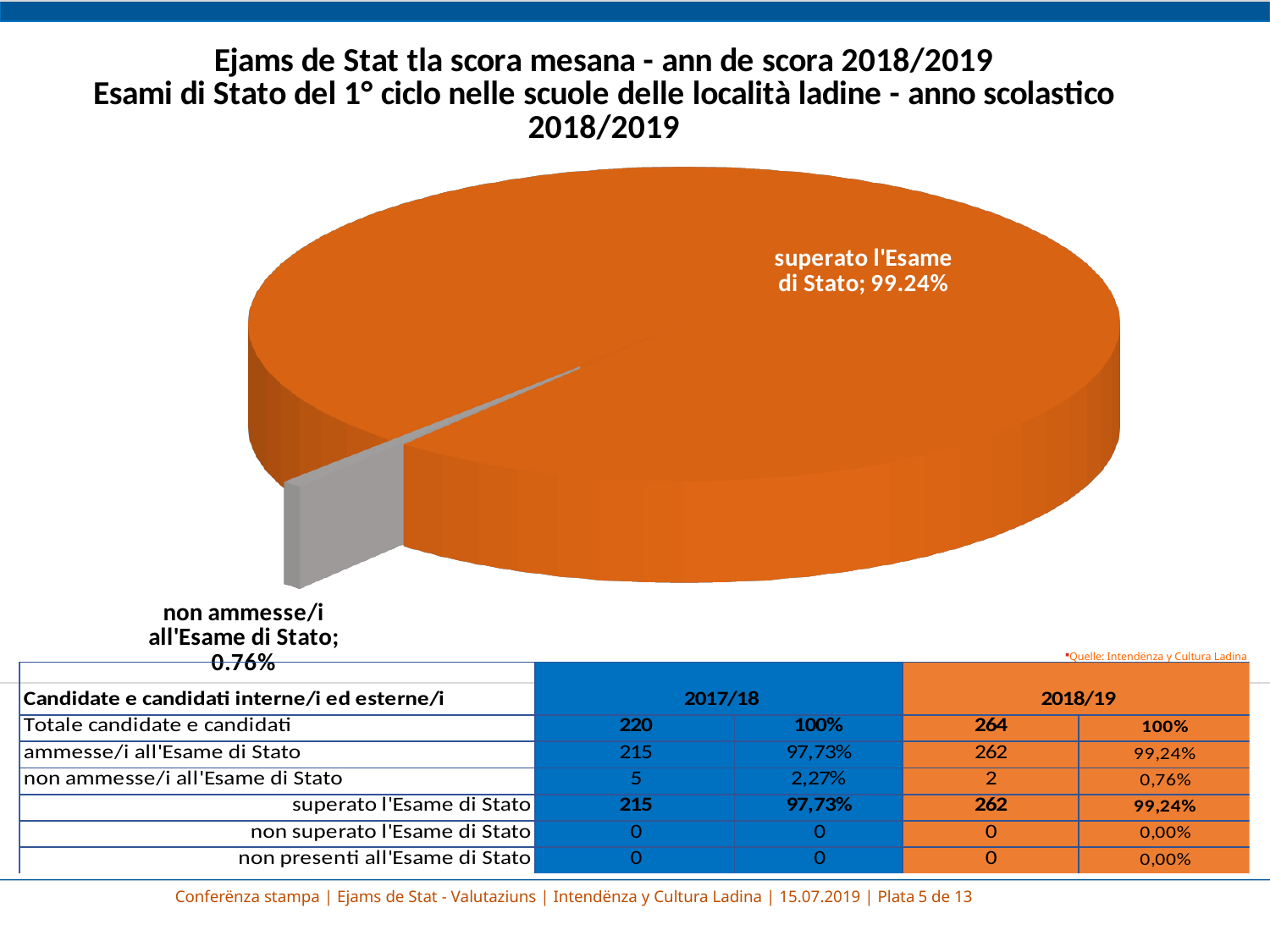
Which slice of the pie chart is the smallest? non ammesse/i all'Esame di Stato What kind of chart is shown on the slide? pie chart What is the value labelled for 'superato l'Esame di Stato' in the pie chart? 99.24% What share of the pie does the slice 'superato l'Esame di Stato' represent? 99.24% How many slices does the pie chart have? 2 What share of the pie does the slice 'non ammesse/i all'Esame di Stato' represent? 0.76% Which school year does the pie chart's title refer to? 2018/2019 Which slice of the pie chart is the largest? superato l'Esame di Stato Which is larger in the pie chart: 'superato l'Esame di Stato' or 'non ammesse/i all'Esame di Stato'? superato l'Esame di Stato What is the value labelled for 'non ammesse/i all'Esame di Stato' in the pie chart? 0.76% What is the difference in percentage points between the 'superato l'Esame di Stato' slice and the 'non ammesse/i all'Esame di Stato' slice? 98.48 What colour is the largest slice of the pie chart? orange